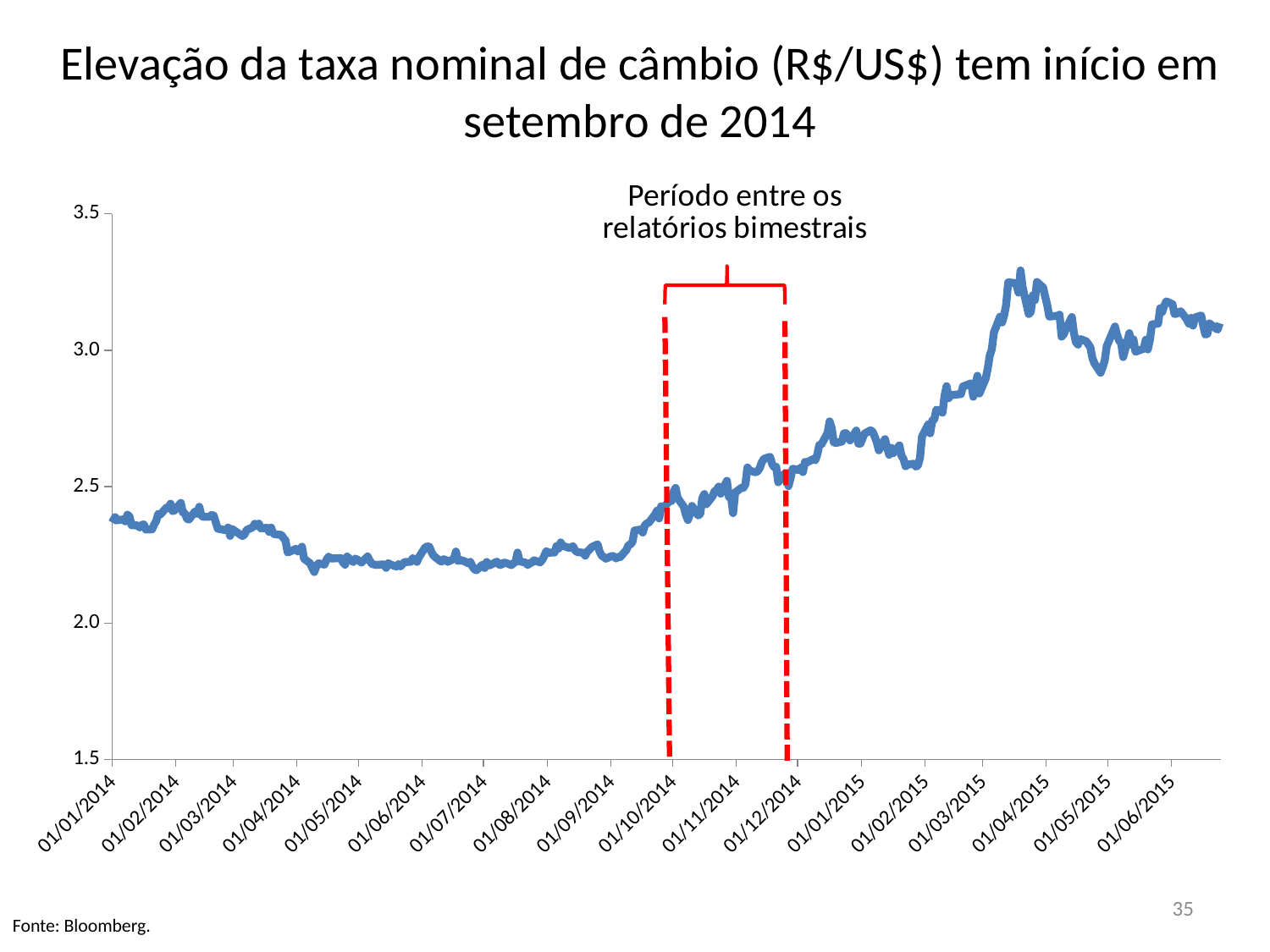
What text labels the red dashed bracket between 01/10/2014 and 01/12/2014? Período entre os relatórios bimestrais Which is larger, the exchange rate at 01/01/2014 or at 01/04/2015? 01/04/2015 Is the highest value reached by the line greater or less than 3.0? greater Is the value of the exchange rate at 01/01/2014 greater or less than 2.5? less What kind of chart is shown on the slide? line chart What is the title of the slide's chart? Elevação da taxa nominal de câmbio (R$/US$) tem início em setembro de 2014 Is the value of the exchange rate at 01/06/2014 greater or less than 2.5? less Overall, does the exchange rate rise or fall from 01/01/2014 to 01/06/2015? rise How many date labels are shown on the x axis? 18 Which is larger, the exchange rate at 01/05/2014 or at 01/12/2014? 01/12/2014